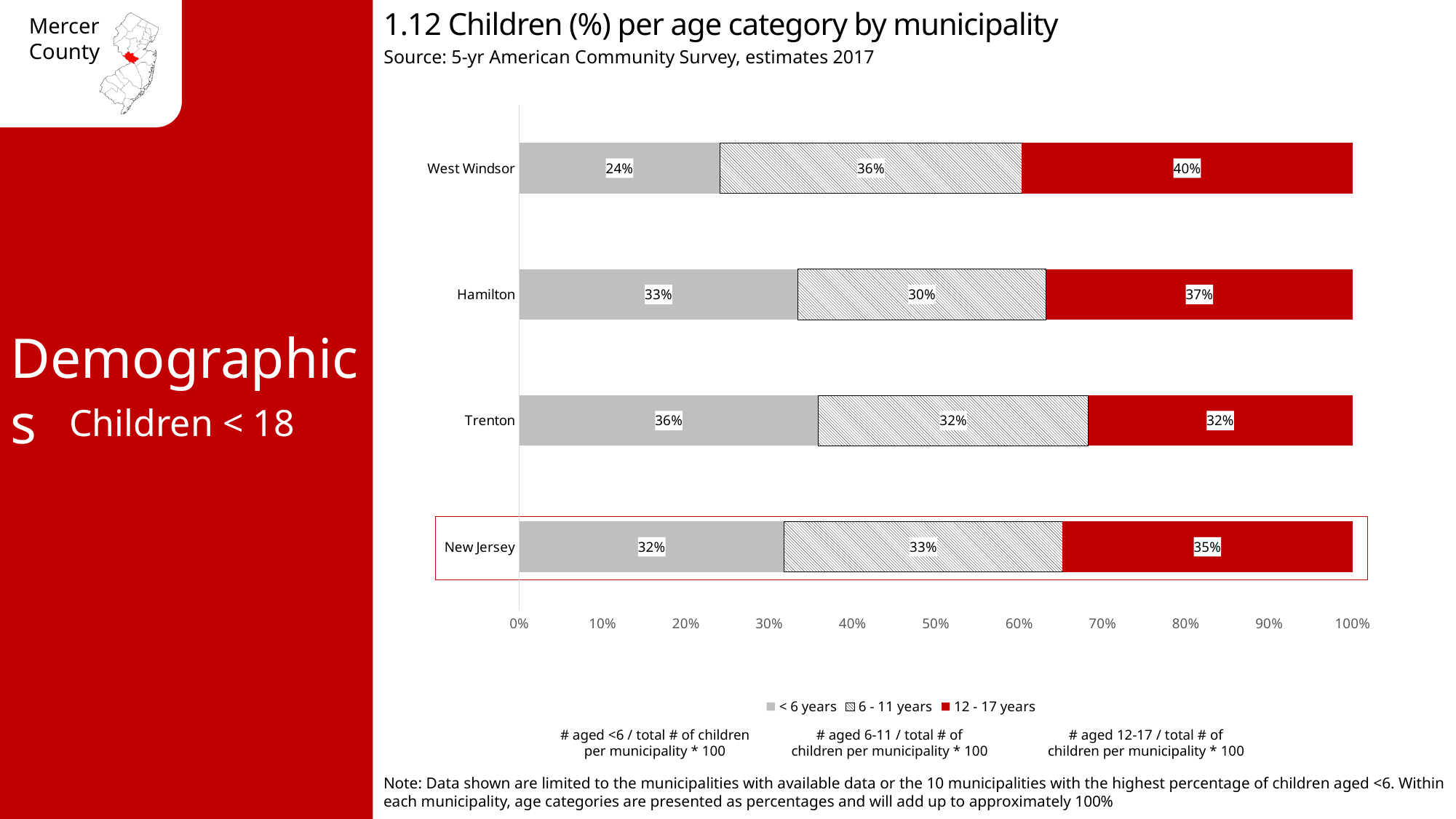
Which category has the highest percentage of children aged 12 - 17 years? West Windsor What is the difference between the < 6 years percentage for Trenton and for West Windsor? 12% What percentage of children in Hamilton are under 6 years old? 33% How many series does the legend list? 3 Which is larger: the 6 - 11 years share in West Windsor or in Hamilton? West Windsor What kind of chart is shown on the slide? Stacked bar chart What percentage of children in West Windsor are aged 12 - 17 years? 40% What percentage of children in Trenton are aged 6 - 11 years? 32% What percentage of children in New Jersey are aged 12 - 17 years? 35% How many municipalities or regions are shown on the chart? 4 Which age category is shown in red on the chart? 12 - 17 years Which municipality has the lowest percentage of children under 6 years? West Windsor